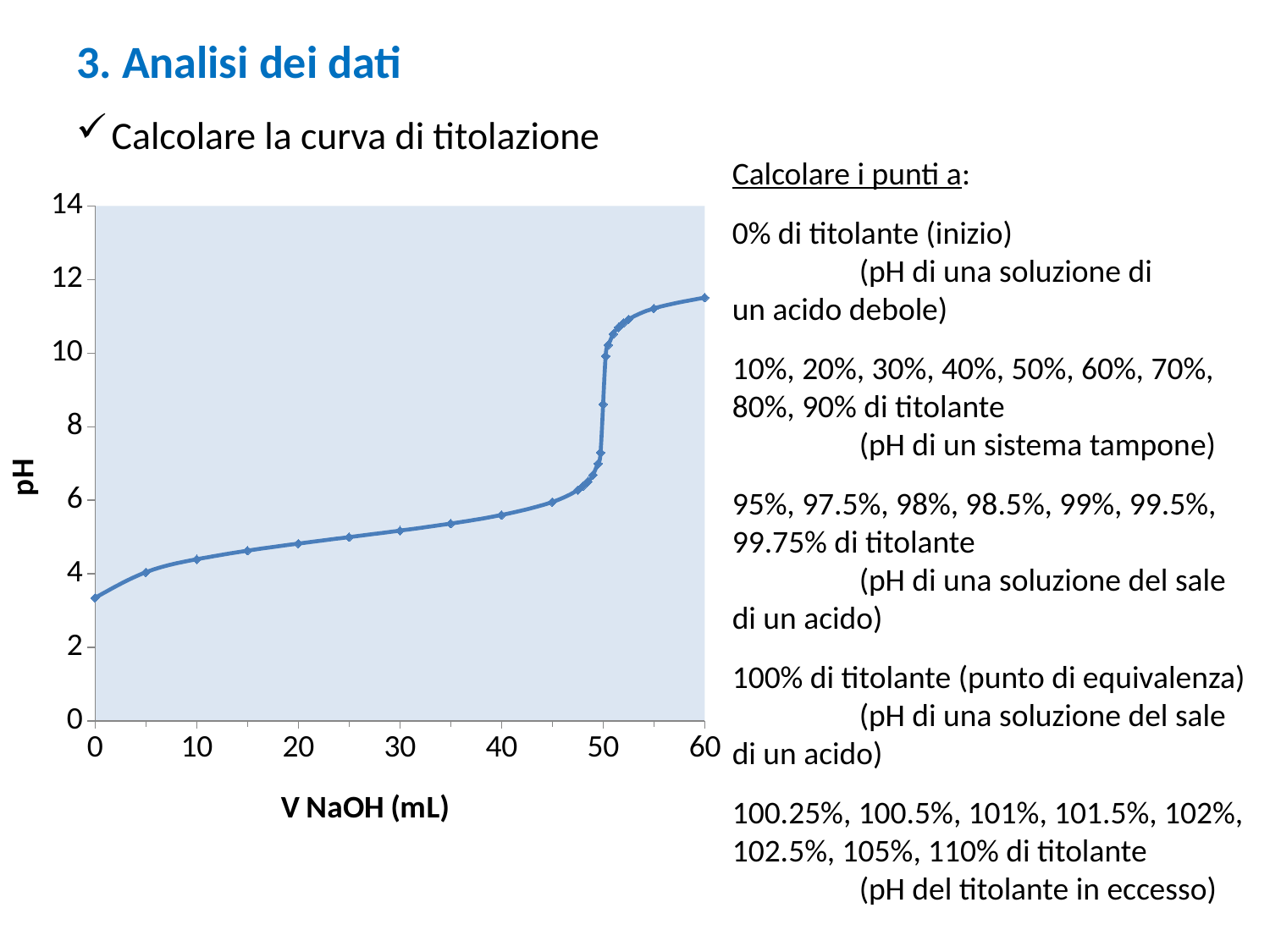
Is the pH at 40 mL of NaOH greater or less than 8? less Is the pH at 30 mL of NaOH greater or less than 6? less What is the label of the y axis of the chart? pH Is the pH at 60 mL of NaOH greater or less than 10? greater At which volume of NaOH shown on the x axis is the pH lowest? 0 What kind of chart is shown on the slide? line chart Does the pH rise or fall as V NaOH increases along the x axis? rise What is the label of the x axis of the chart? V NaOH (mL) Which has the higher pH: 0 mL of NaOH or 60 mL of NaOH? 60 mL At which volume of NaOH shown on the x axis is the pH highest? 60